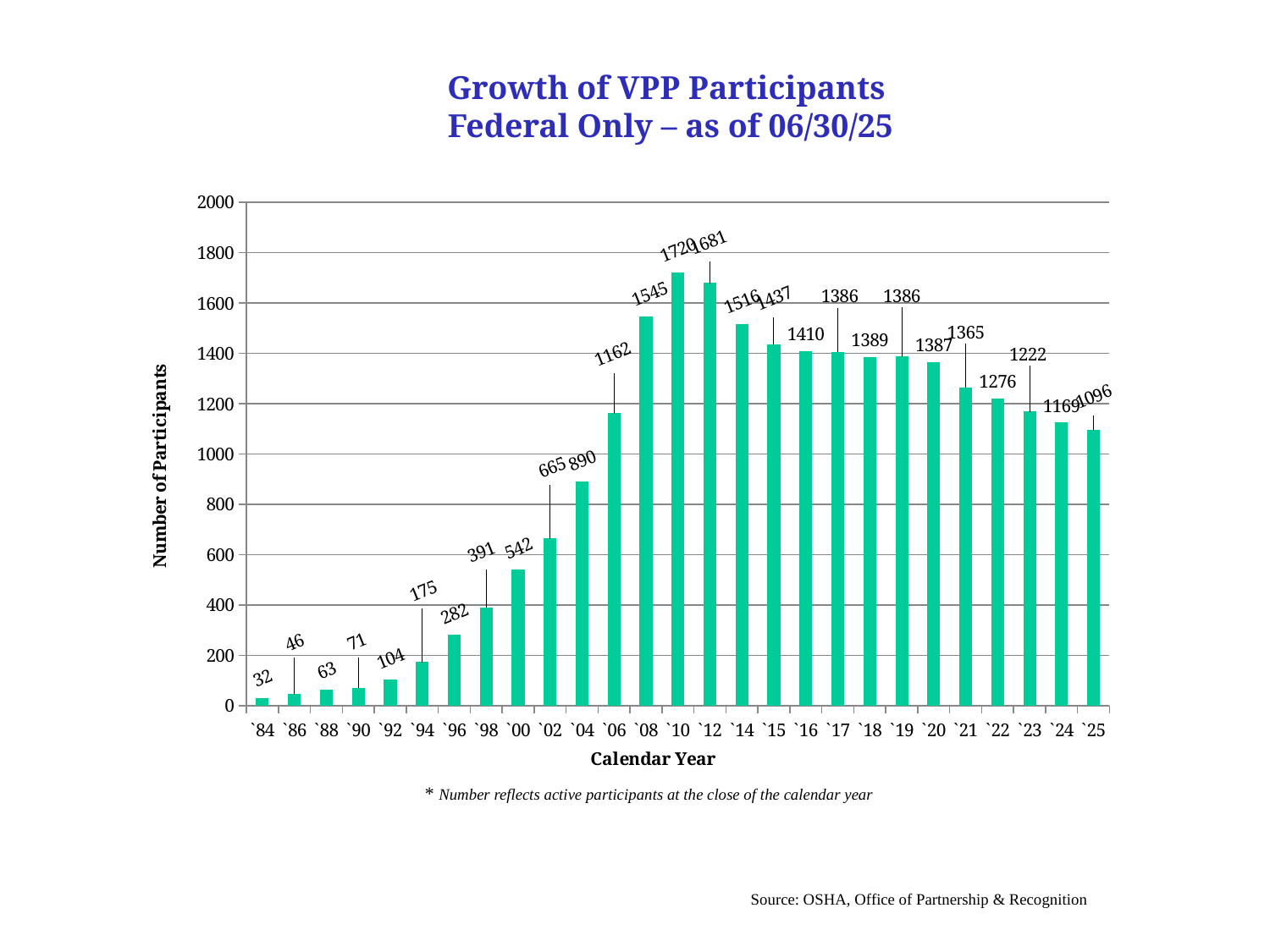
What is the number of participants for `04? 890 Which calendar year has the lowest number of participants? `84 Which calendar year has the highest number of participants? `10 How many participants were there in `84? 32 What is the number of participants for `10? 1720 Which year has more participants, `08 or `12? `12 How many calendar years are shown on the x axis? 27 What is the title of the chart? Growth of VPP Participants Federal Only – as of 06/30/25 What type of chart is shown on the slide? bar chart What is the difference in participants between `08 and `06? 383 What is the number of participants for `25? 1096 What is the difference in participants between `10 and `12? 39